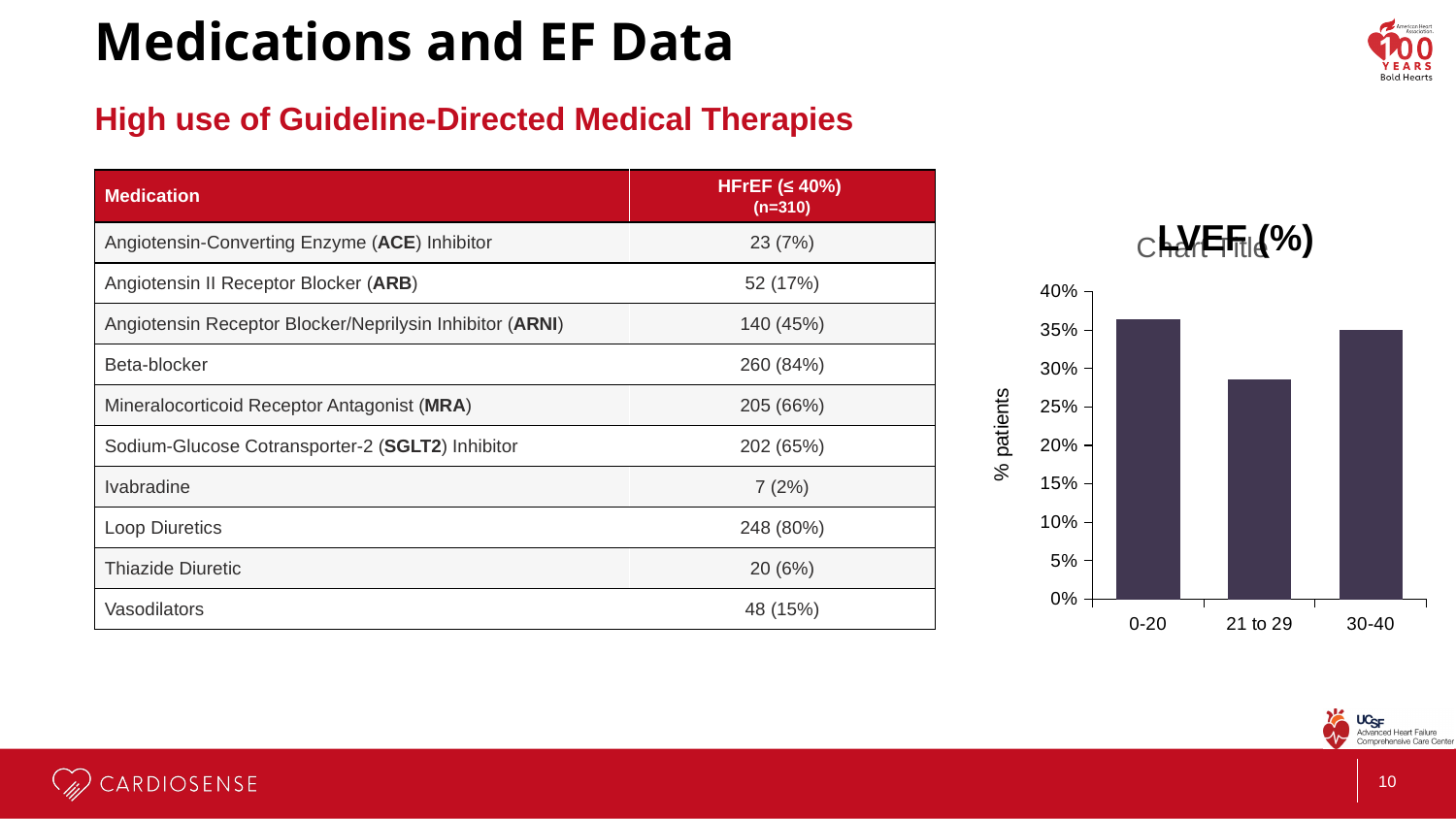
Which has a higher % patients, the 0-20 category or the 21 to 29 category? 0-20 Which LVEF category has the lowest % patients? 21 to 29 How many LVEF categories are plotted on the chart? 3 Which has a higher % patients, the 30-40 category or the 21 to 29 category? 30-40 What is the label on the vertical axis of the chart? % patients What kind of chart is shown on the slide? bar chart Is the value for the 30-40 category greater or less than 40%? less Is the value for the 30-40 category greater or less than 30%? greater Is the value for the 21 to 29 category greater or less than 25%? greater Does the value rise or fall from the 0-20 category to the 21 to 29 category? fall